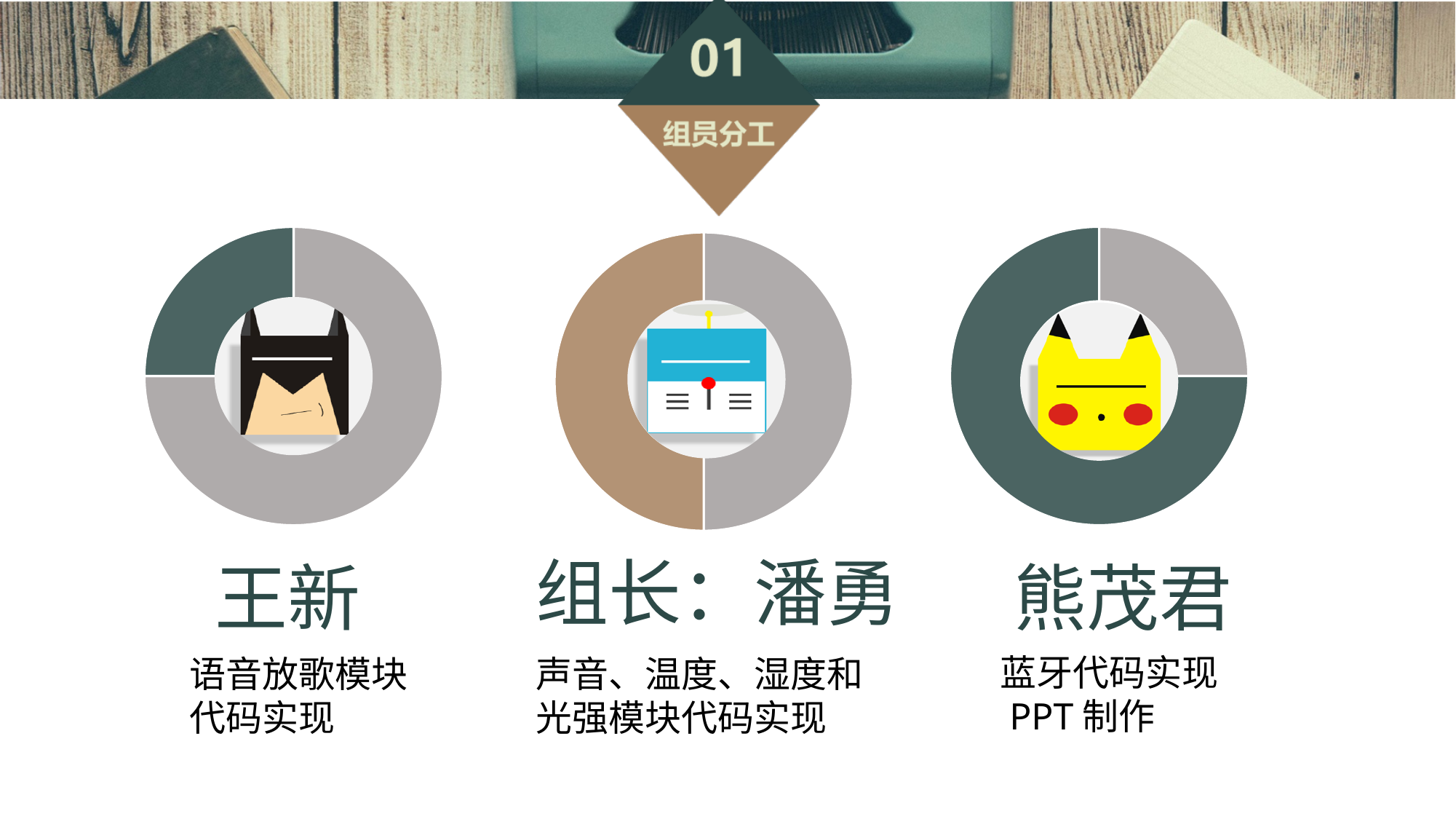
What colour is the highlighted segment of the middle donut chart (组长：潘勇)? brown Is the coloured portion of the donut chart for 潘勇 larger or smaller than that of the donut chart for 王新? larger What kind of chart is shown under each team member's name? donut chart Which team member is labelled as 组长 (group leader) on the slide? 潘勇 Is the coloured portion of the donut chart for 熊茂君 larger or smaller than that of the donut chart for 潘勇? larger How many donut charts are on the slide? 3 Which donut chart has the largest coloured (non-grey) portion: the one for 王新, 潘勇, or 熊茂君? 熊茂君 Which donut chart has the smallest coloured (non-grey) portion: the one for 王新, 潘勇, or 熊茂君? 王新